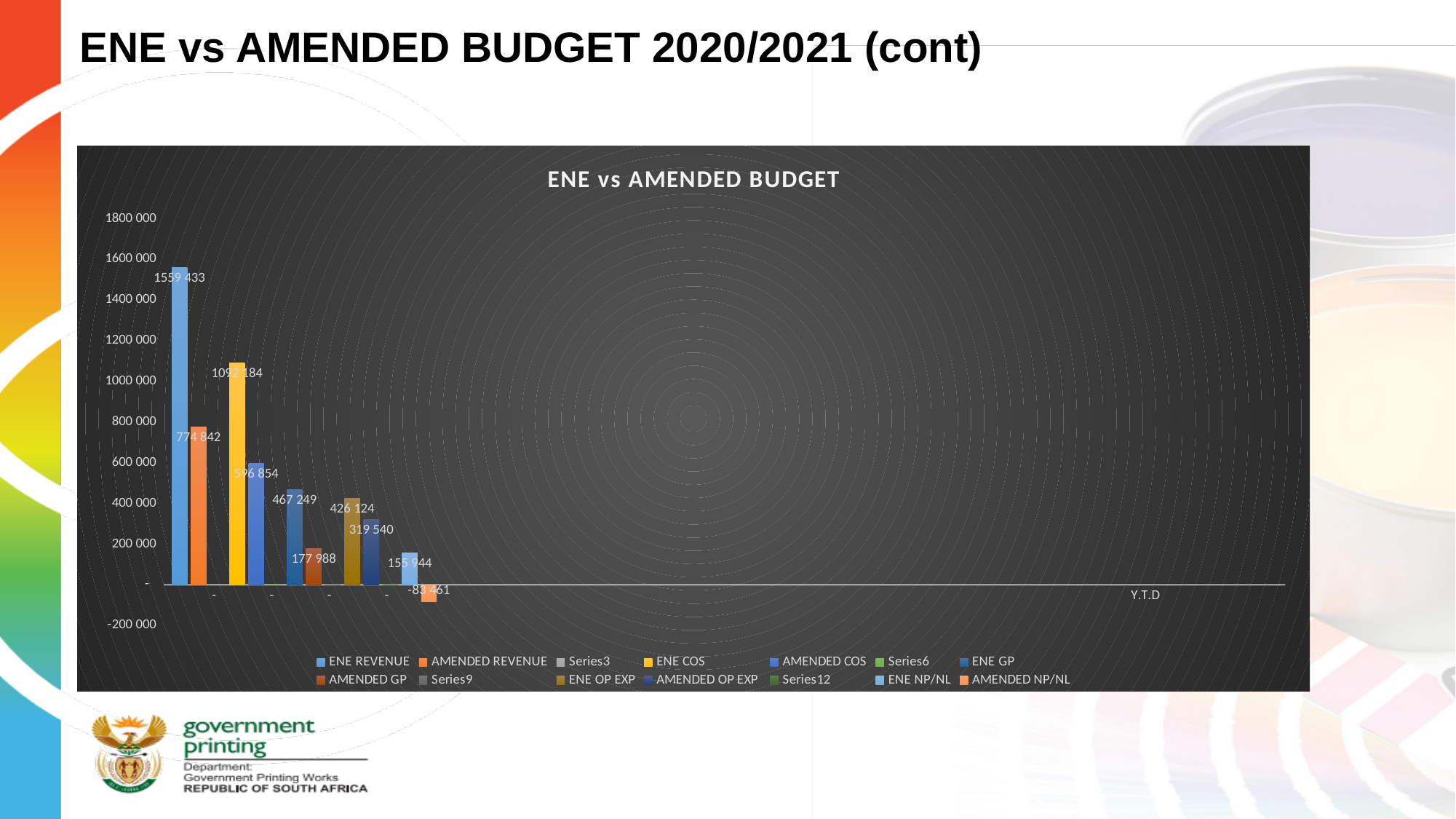
How many series does the legend list? 14 What kind of chart is shown on the slide? bar chart What is the difference between the ENE REVENUE value and the AMENDED REVENUE value? 784 591 What is the value of the ENE REVENUE bar? 1559 433 Which series has the lowest value in the chart? AMENDED NP/NL Which series has the highest value in the chart? ENE REVENUE Which is larger, the ENE OP EXP value or the AMENDED OP EXP value? ENE OP EXP What is the difference between the ENE GP value and the AMENDED GP value? 289 261 What is the value of the AMENDED NP/NL bar? -83 461 What is the value of the ENE COS bar? 1092 184 What is the title of the chart? ENE vs AMENDED BUDGET What is the value of the AMENDED REVENUE bar? 774 842